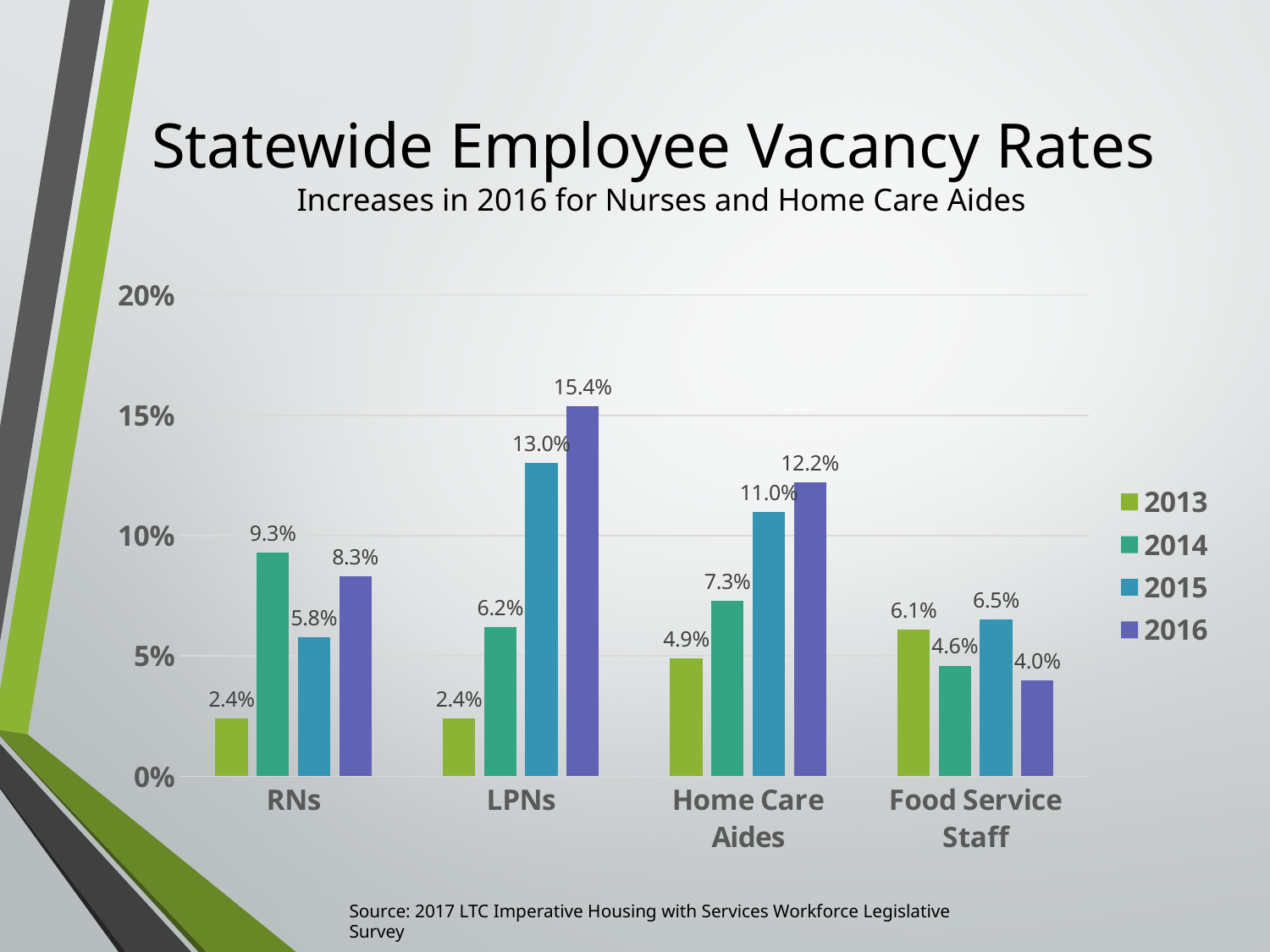
What is the vacancy rate for Food Service Staff in 2013? 6.1% What is the difference between the 2016 and 2015 vacancy rates for LPNs? 2.4% How many series does the legend list? 4 Is the 2015 vacancy rate for Home Care Aides greater or less than 10%? greater What kind of chart is shown on the slide? Bar chart What is the vacancy rate for Home Care Aides in 2014? 7.3% What is the vacancy rate for LPNs in 2016? 15.4% Which category has the lowest vacancy rate in 2016? Food Service Staff Which category has the highest vacancy rate in 2016? LPNs Which is larger, the 2014 vacancy rate for RNs or the 2016 vacancy rate for RNs? 2014 How many job categories are shown on the x axis? 4 Do the vacancy rates for LPNs rise or fall from 2013 to 2016? Rise